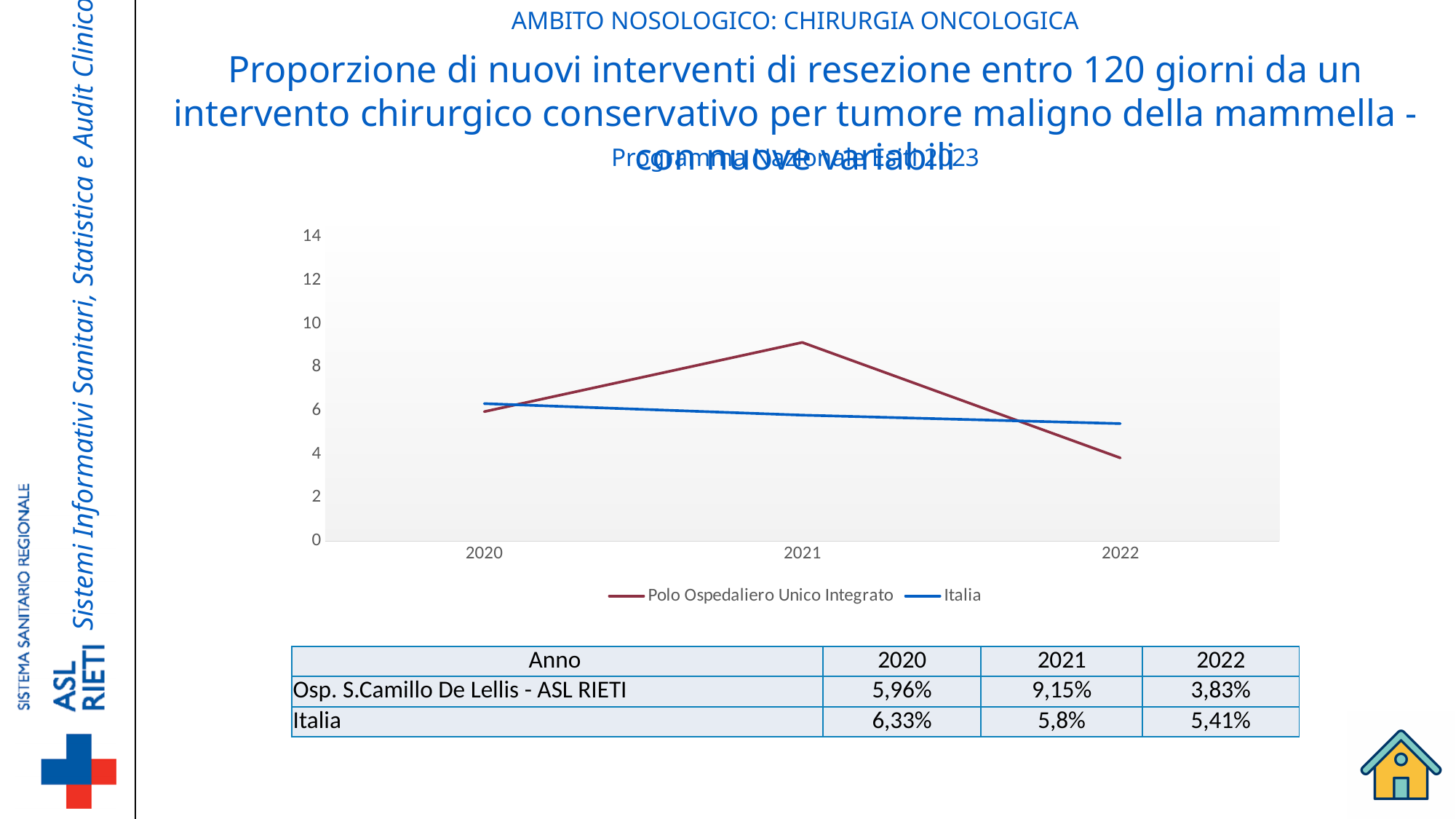
How many series does the chart legend list? 2 What kind of chart is shown on the slide? line chart Is the value for Polo Ospedaliero Unico Integrato in 2021 greater or less than 8? greater How many years are plotted along the x axis of the chart? 3 In which year does the Polo Ospedaliero Unico Integrato line reach its lowest value? 2022 In 2022, which series has the larger value, Polo Ospedaliero Unico Integrato or Italia? Italia According to the table, what is the value for Italia in 2020? 6,33% According to the table, what is the value for Osp. S.Camillo De Lellis - ASL RIETI in 2021? 9,15% Does the Italia line rise or fall from 2020 to 2022? fall In which year does the Polo Ospedaliero Unico Integrato line reach its highest value? 2021 Using the table values, what is the difference between Osp. S.Camillo De Lellis - ASL RIETI and Italia in 2021? 3,35% According to the table, what is the value for Italia in 2022? 5,41%